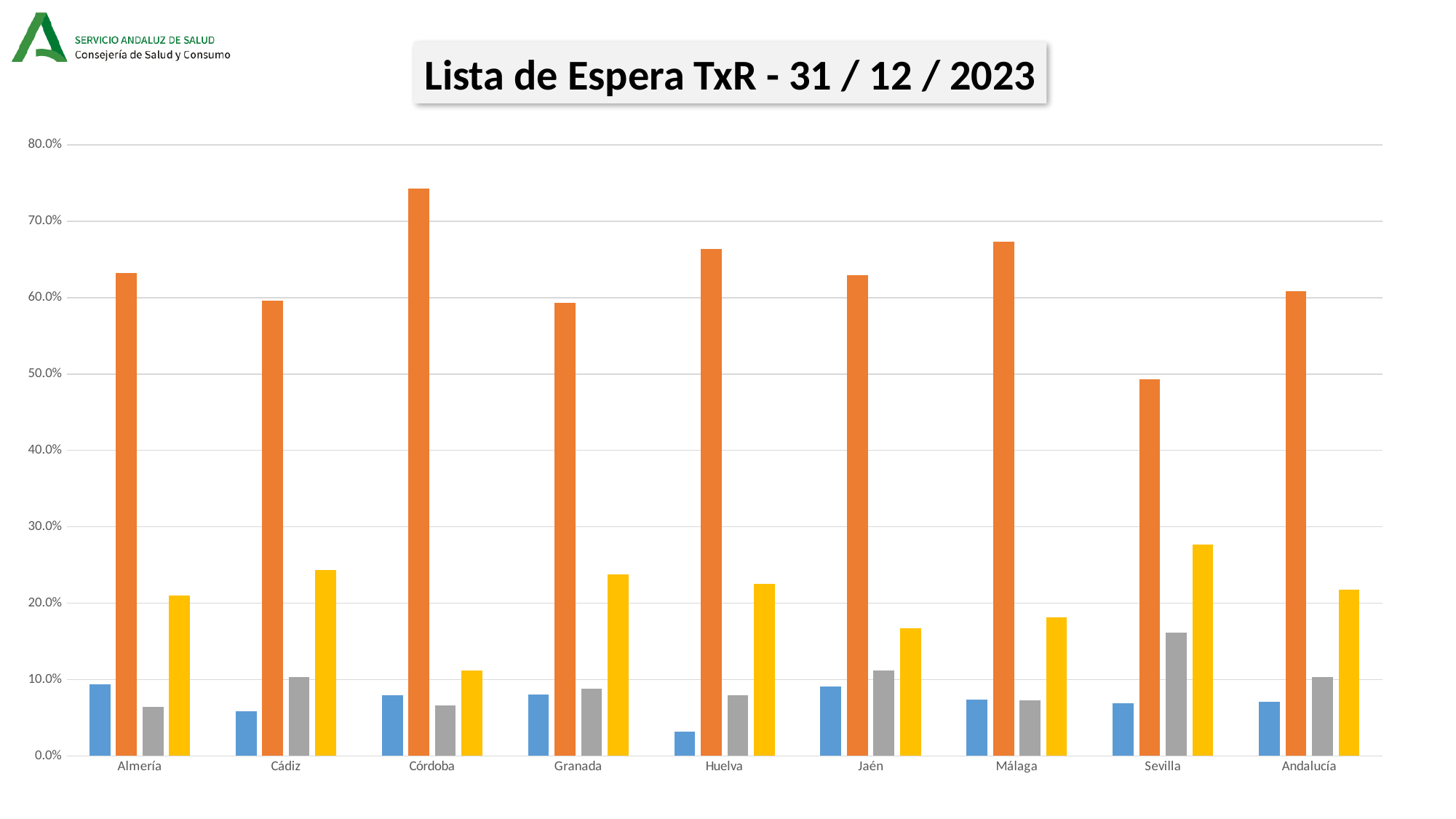
Is the orange bar for Córdoba greater or less than 70.0%? greater Which category has the lowest orange bar? Sevilla Which category has the highest yellow bar? Sevilla Is the orange bar for Sevilla greater or less than 50.0%? less Which is larger, the grey bar for Sevilla or the grey bar for Málaga? Sevilla Which category has the highest orange bar? Córdoba What kind of chart is shown on the slide? Bar chart What is the title of the chart? Lista de Espera TxR - 31 / 12 / 2023 How many bars are plotted for each category? 4 How many categories are shown along the x axis? 9 Which category has the lowest yellow bar? Córdoba Which category has the lowest blue bar? Huelva